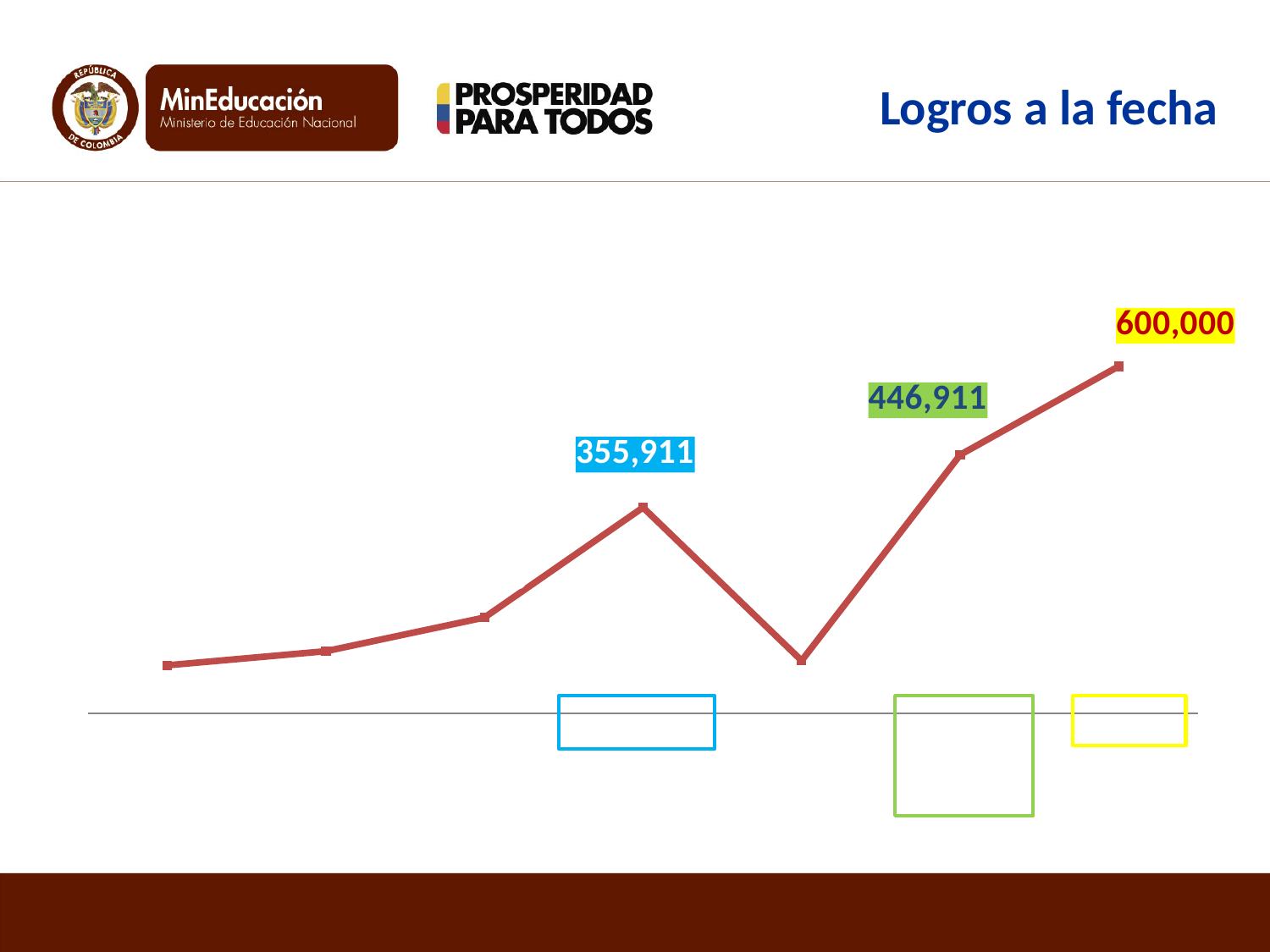
Which of the labelled points has the highest value? 600,000 What is the value of the rightmost (last) point on the line? 600,000 Does the line end higher or lower than where it starts? higher How many data points are plotted on the line? 7 What kind of chart is shown on the slide? line chart Which of the labelled points has the lowest value? 355,911 What is the title shown at the top right of the slide? Logros a la fecha Which is larger, the value labelled in green or the value labelled in blue? the green one, 446,911 What is the difference between the 600,000 point and the 446,911 point? 153,089 What is the value of the fourth point from the left, the one labelled in blue? 355,911 What is the difference between the 446,911 point and the 355,911 point? 91,000 What is the value of the sixth point from the left, the one labelled in green? 446,911